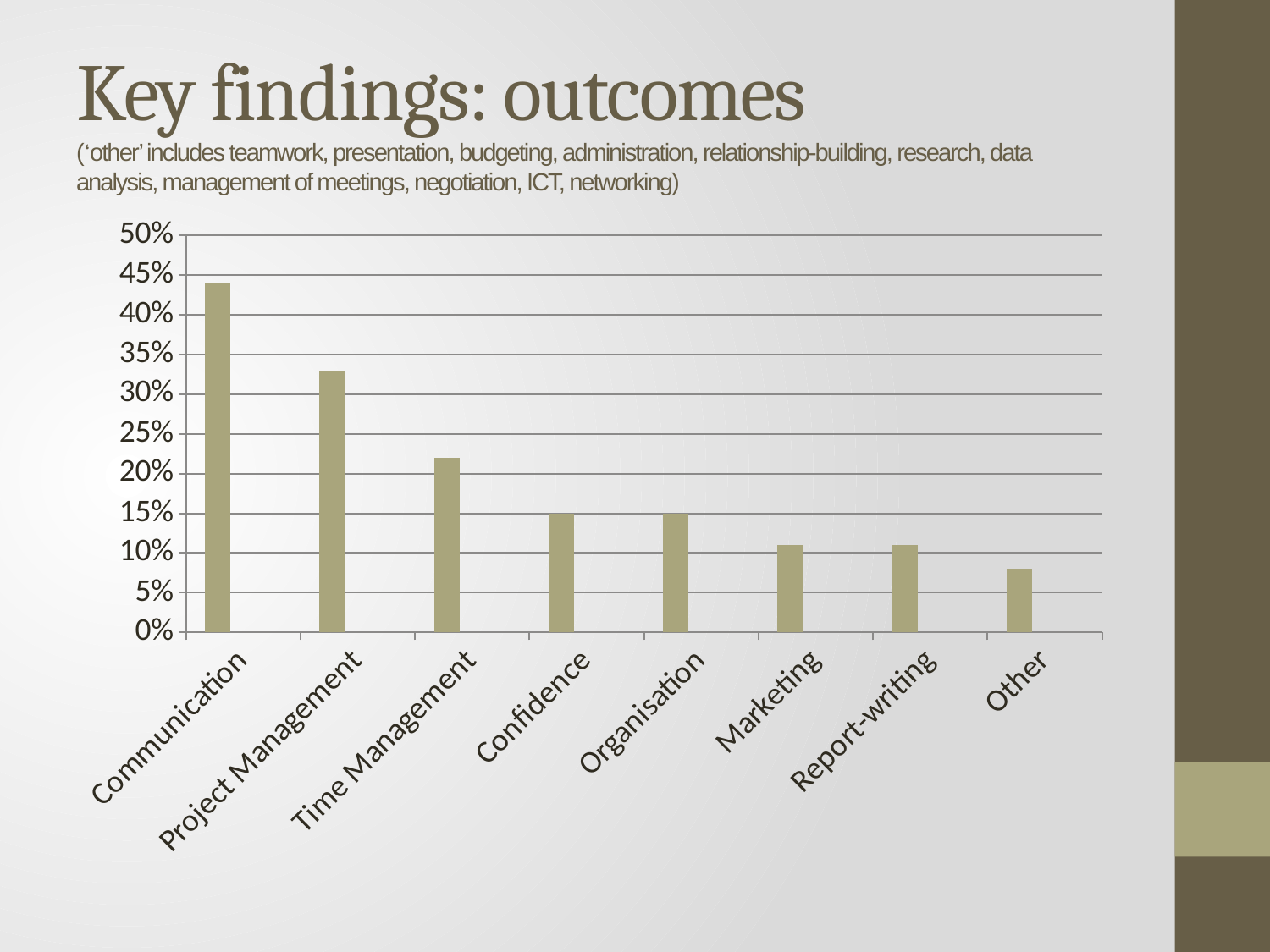
Which category has the lowest value in the chart? Other What kind of chart is shown on the slide? bar chart What is the title of the slide containing the chart? Key findings: outcomes Which is larger, the value for Time Management or the value for Marketing? Time Management Is the value for Communication greater or less than 40%? greater How many categories are shown on the x axis of the chart? 8 Is the value for Time Management greater or less than 20%? greater Is the value for Other greater or less than 10%? less Which category has the highest value in the chart? Communication Do the values generally rise or fall moving from left to right along the x axis? fall What is the value for Confidence? 15%